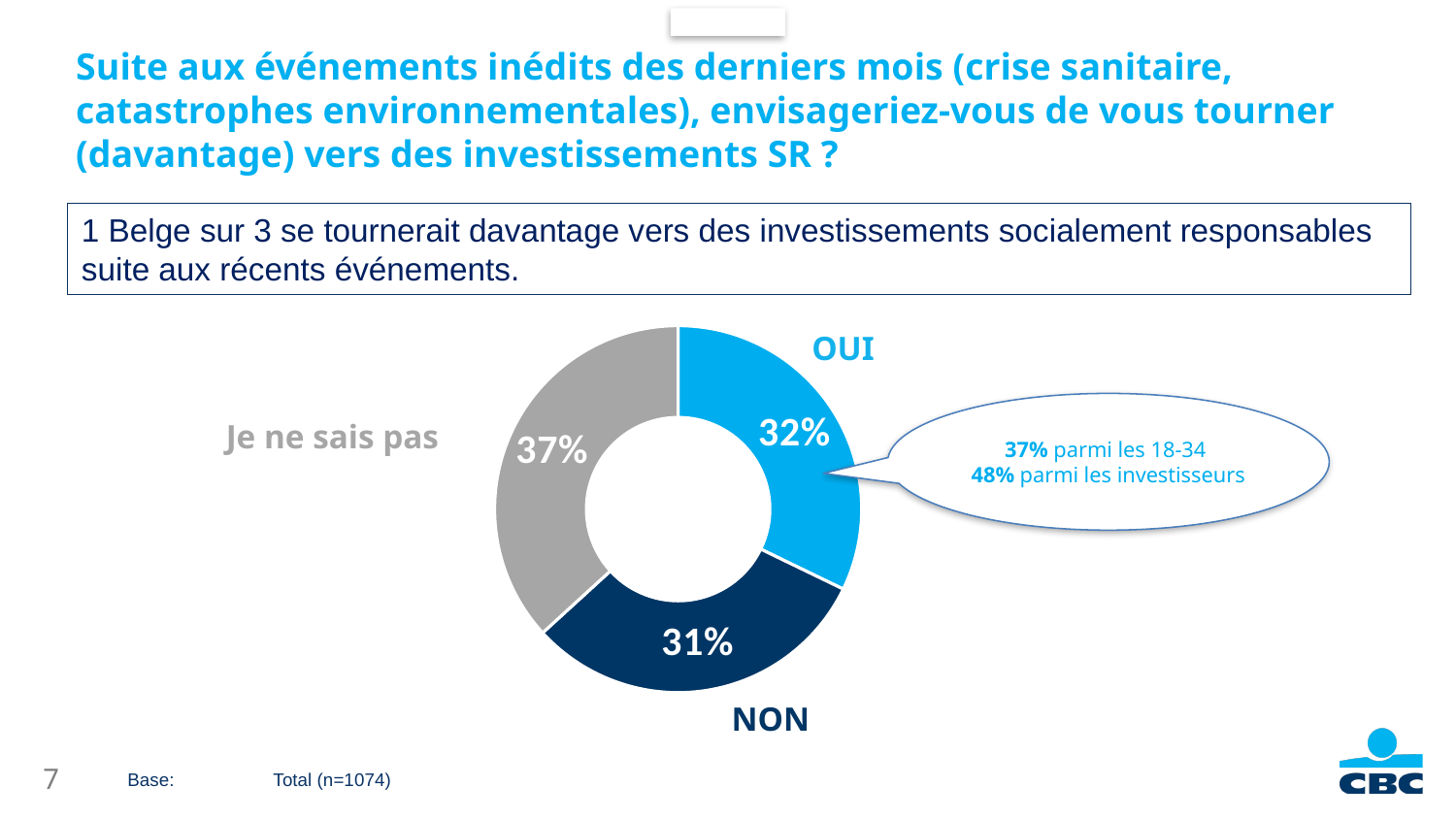
What is the difference in percentage points between 'Je ne sais pas' and OUI? 5 How many response categories are shown in the chart? 3 Which response category has the largest share of the pie? Je ne sais pas What kind of chart is shown on the slide? Pie chart (donut) What colour is the OUI slice of the chart? Light blue What percentage of respondents answered 'Je ne sais pas'? 37% Which response category has the smallest share of the pie? NON What percentage of respondents answered OUI? 32% What percentage of respondents answered NON? 31% According to the callout, what percentage of investors (investisseurs) answered OUI? 48% What is the combined share of OUI and NON? 63% What is the difference in percentage points between OUI and NON? 1